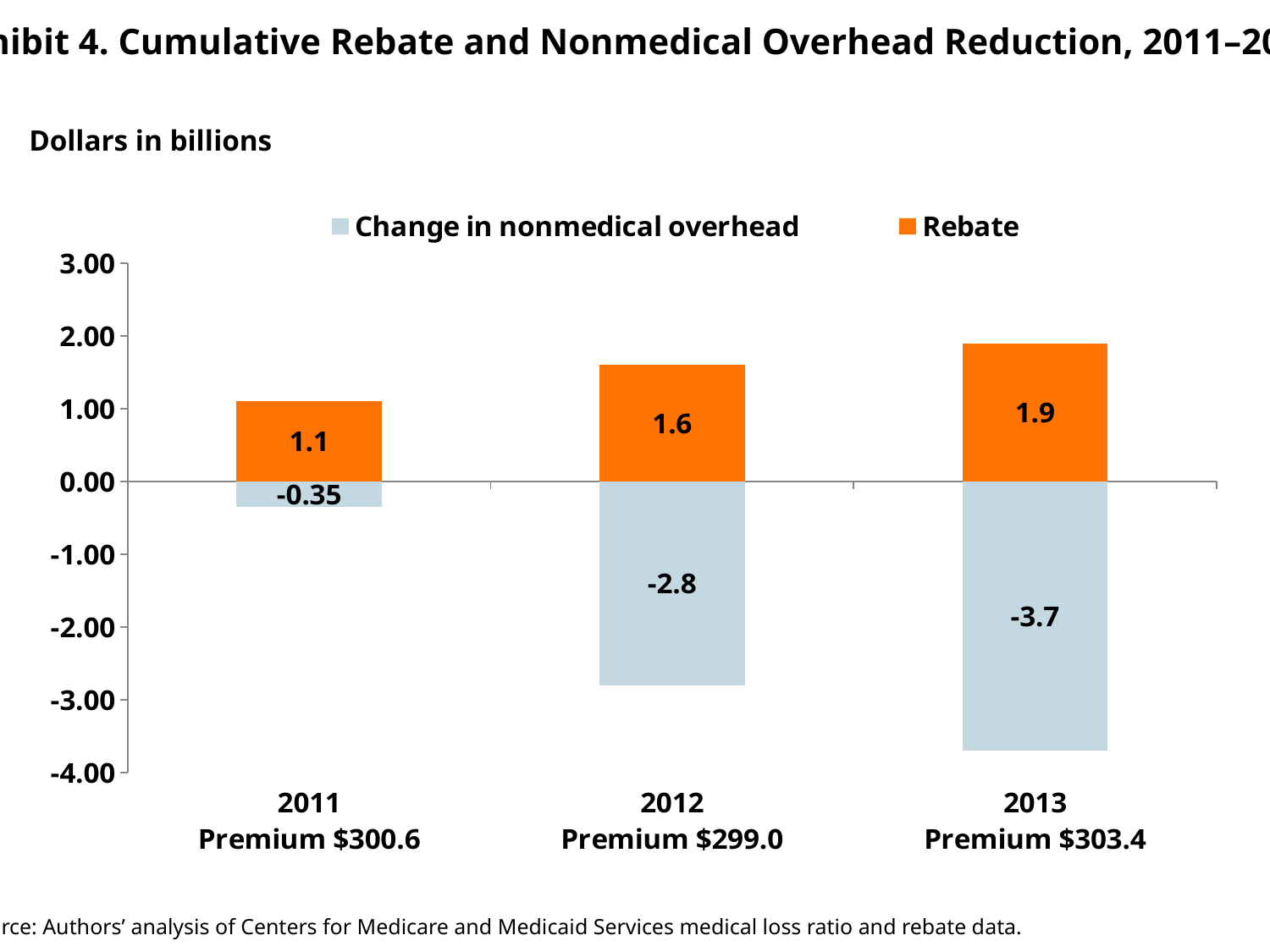
Which year has the lowest Rebate value? 2011 Do the Rebate values rise or fall from 2011 to 2013? rise What kind of chart is shown on the slide? bar chart Which year has the highest Rebate value? 2013 What is the Change in nonmedical overhead value for 2011? -0.35 How many series does the legend list? 2 What is the difference between the Rebate value for 2013 and the Rebate value for 2011? 0.8 Which year has the larger Rebate value, 2012 or 2013? 2013 What is the Rebate value for 2012? 1.6 How many years are shown on the x axis? 3 What is the Change in nonmedical overhead value for 2013? -3.7 What colour represents the Rebate series in the legend? orange